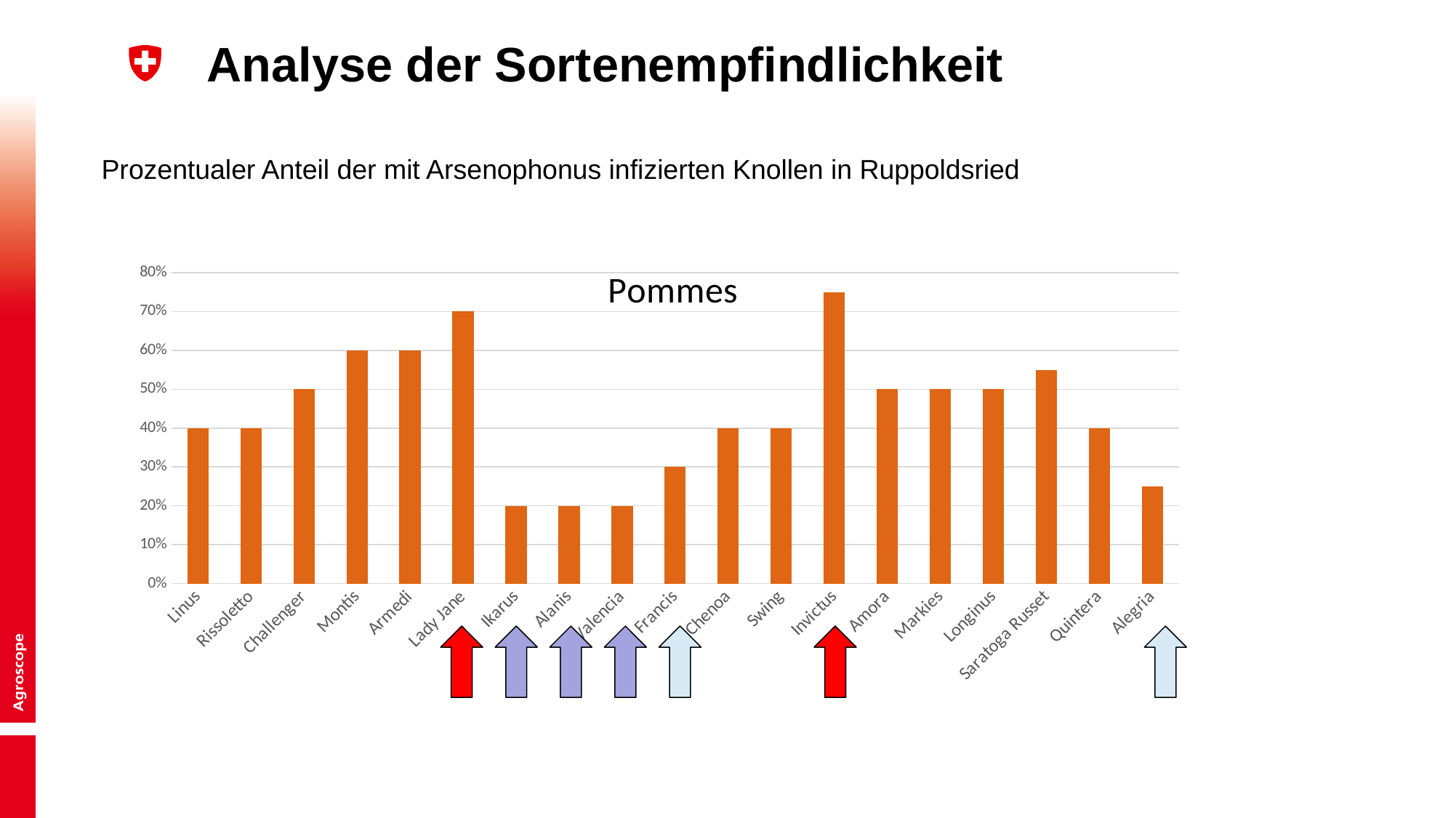
What is the value for Montis? 60% Is the value for Alegria greater or less than 30%? less What kind of chart is shown on the slide? Bar chart Which category has the highest value? Invictus Is the value for Saratoga Russet greater or less than 50%? greater What is the difference between the values for Lady Jane and Ikarus? 50% How many categories are shown on the x axis? 19 Which is larger, the value for Lady Jane or the value for Montis? Lady Jane Is the value for Invictus greater or less than 70%? greater What is the value for Lady Jane? 70% What is the value for Francis? 30% What is the value for Ikarus? 20%